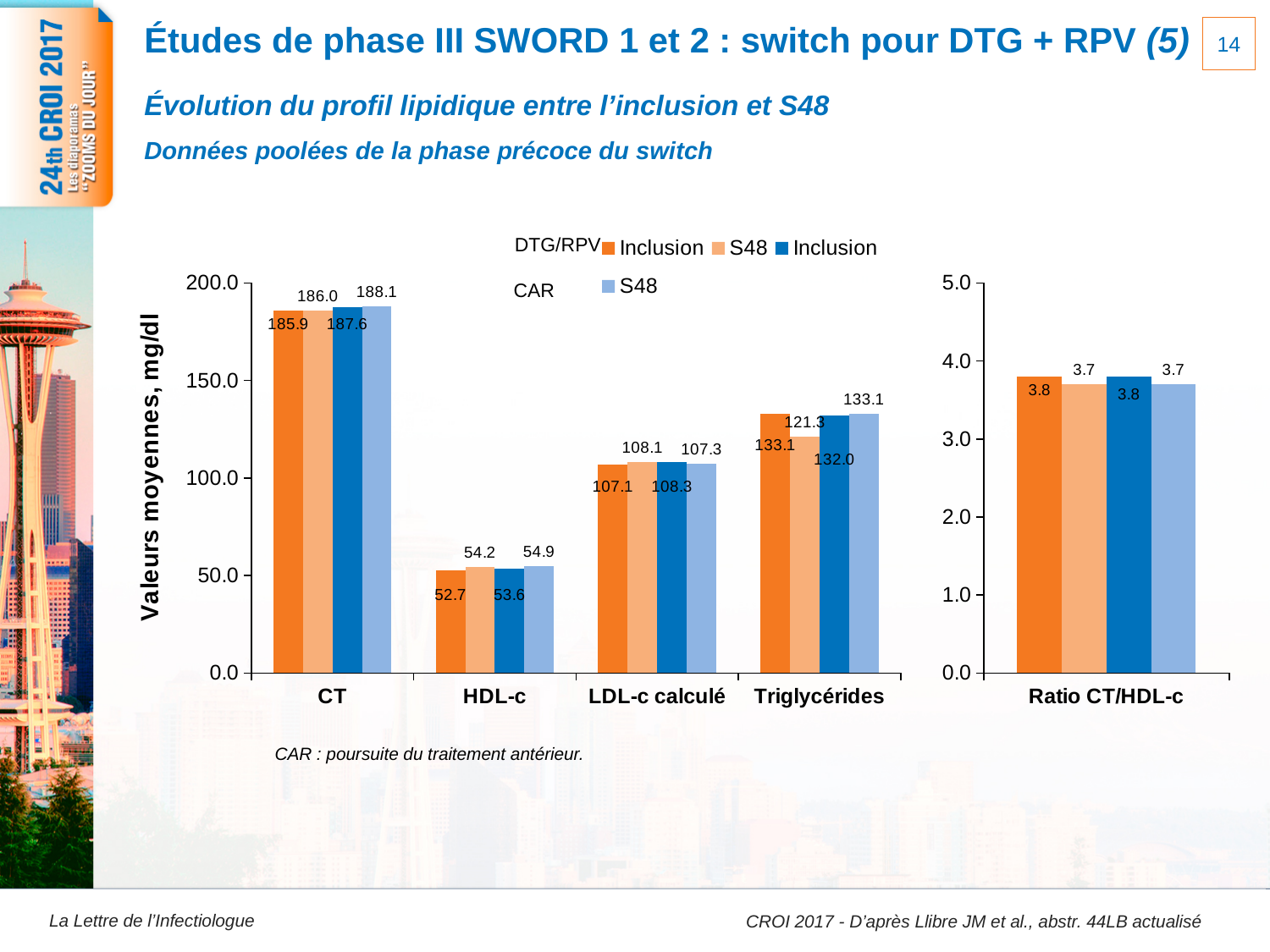
In the left chart, what is the difference between the DTG/RPV Inclusion and DTG/RPV S48 values for Triglycérides? 11.8 How many categories are shown on the x axis of the left chart? 4 What type of chart is used on this slide? Bar chart How many series does the legend list? 4 In the left chart, which category has the highest values? CT In the left chart, which is larger for HDL-c: the DTG/RPV S48 value or the DTG/RPV Inclusion value? DTG/RPV S48 In the left chart, what is the DTG/RPV S48 value for Triglycérides? 121.3 In the left chart, what is the CAR S48 value for HDL-c? 54.9 In the left chart, which category has the lowest values? HDL-c In the right chart (Ratio CT/HDL-c), what is the DTG/RPV S48 value? 3.7 In the left chart, what is the DTG/RPV Inclusion value for CT? 185.9 In the left chart, what is the CAR Inclusion value for LDL-c calculé? 108.3